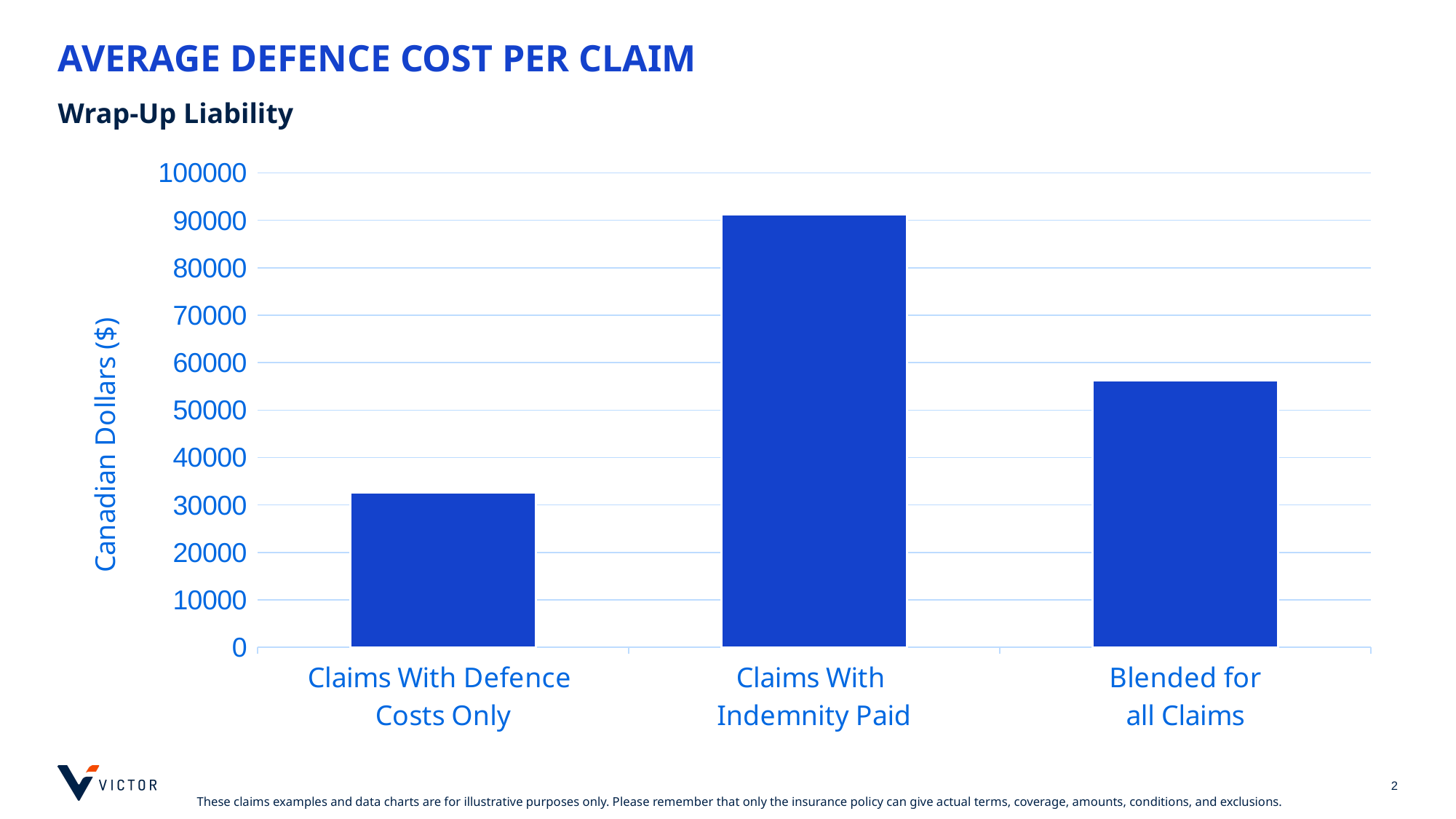
What kind of chart is shown on the slide? bar chart What is the label of the vertical axis of the chart? Canadian Dollars ($) Is the value for Blended for all Claims greater or less than 50000? greater Is the value for Blended for all Claims greater or less than 60000? less Is the value for Claims With Defence Costs Only greater or less than 40000? less Which is larger: the value for Claims With Indemnity Paid or the value for Blended for all Claims? Claims With Indemnity Paid Which is larger: the value for Blended for all Claims or the value for Claims With Defence Costs Only? Blended for all Claims Which category has the lowest average defence cost per claim? Claims With Defence Costs Only Which category has the highest average defence cost per claim? Claims With Indemnity Paid How many categories are shown on the x axis of the chart? 3